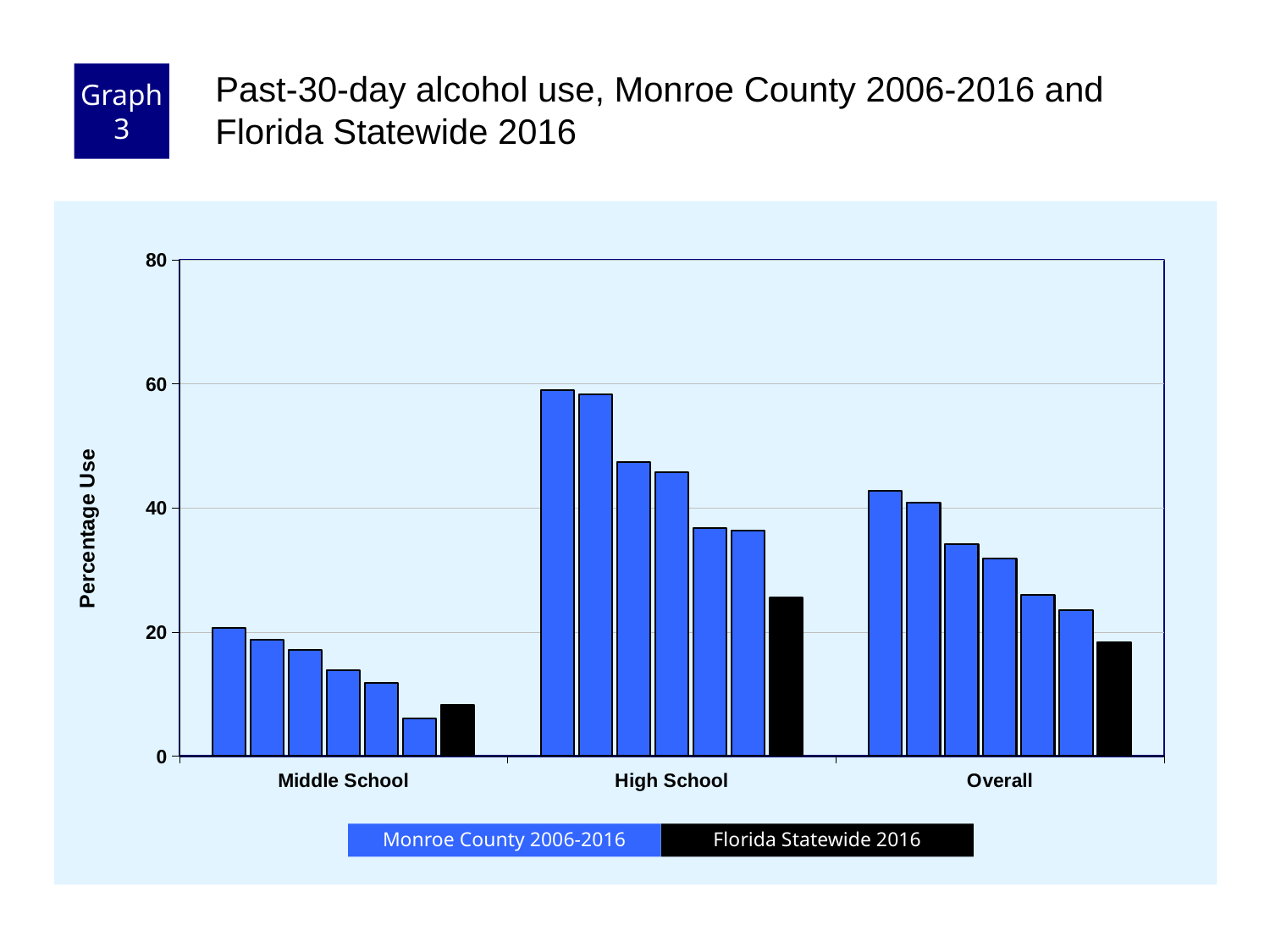
Do the Monroe County 2006-2016 bars rise or fall from left to right within the High School group? fall Which is larger, the Florida Statewide 2016 value for High School or for Middle School? High School Is the Florida Statewide 2016 value for High School greater or less than 20? greater Is the tallest Monroe County 2006-2016 bar for High School greater or less than 40? greater How many categories are shown on the x axis? 3 Which category has the highest bars? High School What is the label on the y axis? Percentage Use Which category has the lowest bars? Middle School How many series does the legend list? 2 What colour are the Florida Statewide 2016 bars? black Is the Florida Statewide 2016 value for Middle School greater or less than 20? less What kind of chart is shown on the slide? bar chart